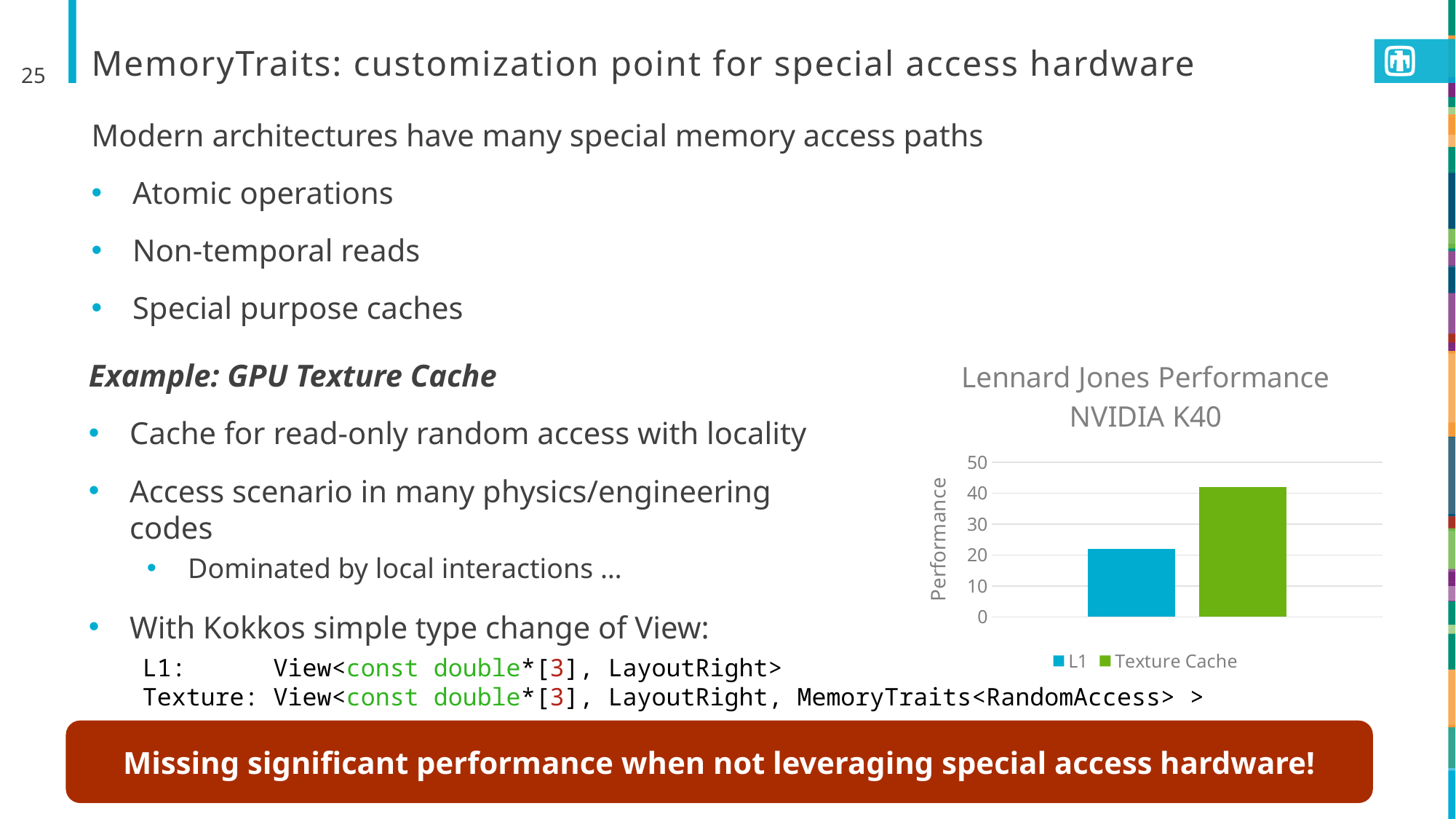
Which is larger in the chart, the L1 bar or the Texture Cache bar? Texture Cache What is the title of the chart? Lennard Jones Performance NVIDIA K40 What kind of chart is shown on the slide? bar chart How many bars are plotted in the chart? 2 Which series has the highest bar in the Lennard Jones Performance chart? Texture Cache How many series does the legend of the chart list? 2 Is the value for L1 greater or less than 10? greater Is the value for Texture Cache greater or less than 30? greater Which series has the lowest bar in the Lennard Jones Performance chart? L1 Is the value for L1 greater or less than 30? less What is the label on the vertical axis of the chart? Performance